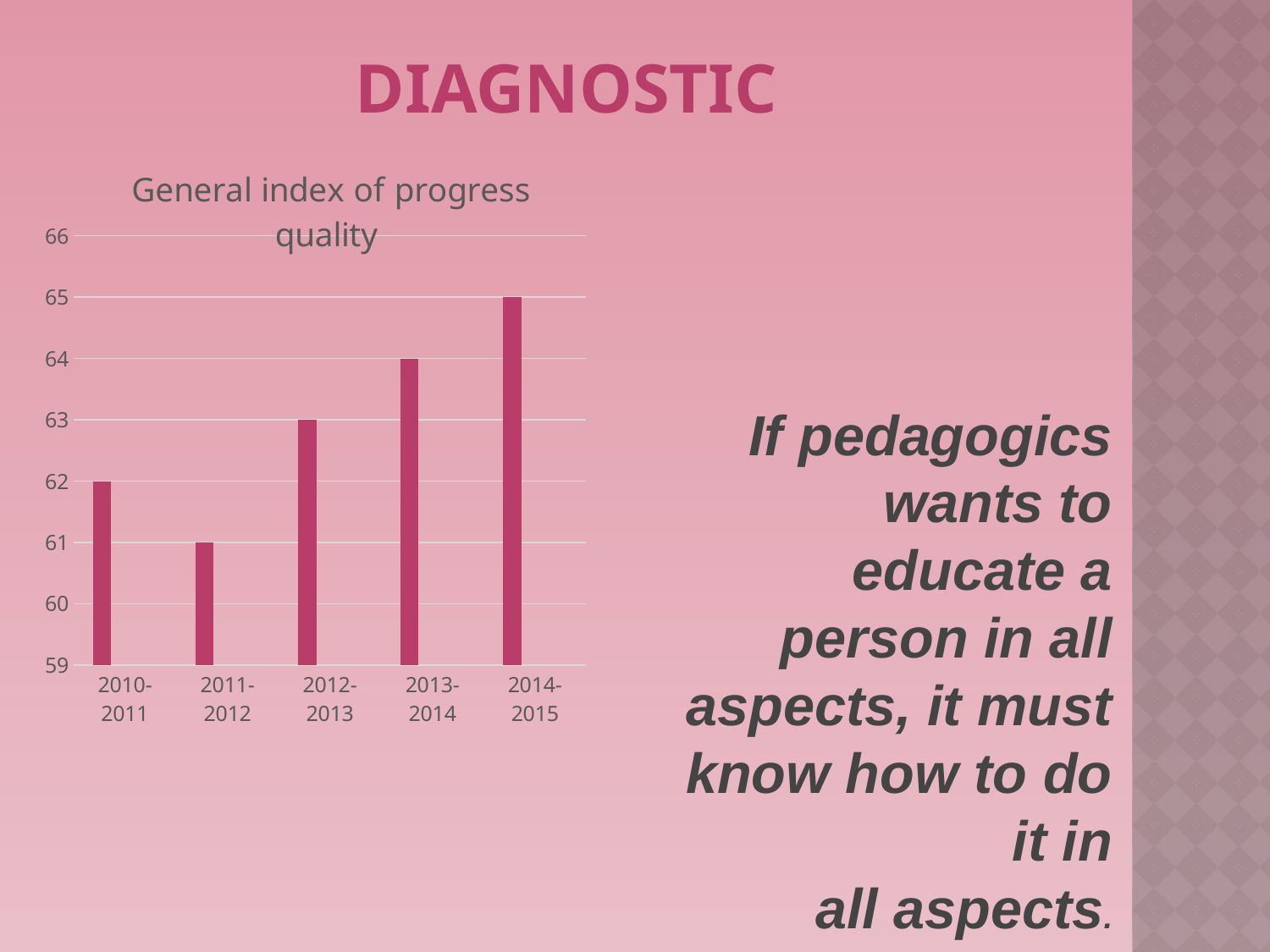
Which is larger in the General index of progress quality chart, the value for 2012-2013 or the value for 2013-2014? 2013-2014 Which period has the highest value in the General index of progress quality chart? 2014-2015 What is the difference between the values for 2014-2015 and 2010-2011 in the General index of progress quality chart? 3 How many periods are shown on the x axis of the General index of progress quality chart? 5 What is the value for 2010-2011 in the General index of progress quality chart? 62 Do the values in the General index of progress quality chart rise or fall from 2011-2012 to 2014-2015? rise What kind of chart is the General index of progress quality chart? bar chart Is the value for 2013-2014 in the General index of progress quality chart greater or less than 62? greater What is the value for 2014-2015 in the General index of progress quality chart? 65 What is the title of the chart on the slide? General index of progress quality Which period has the lowest value in the General index of progress quality chart? 2011-2012 What is the value for 2011-2012 in the General index of progress quality chart? 61